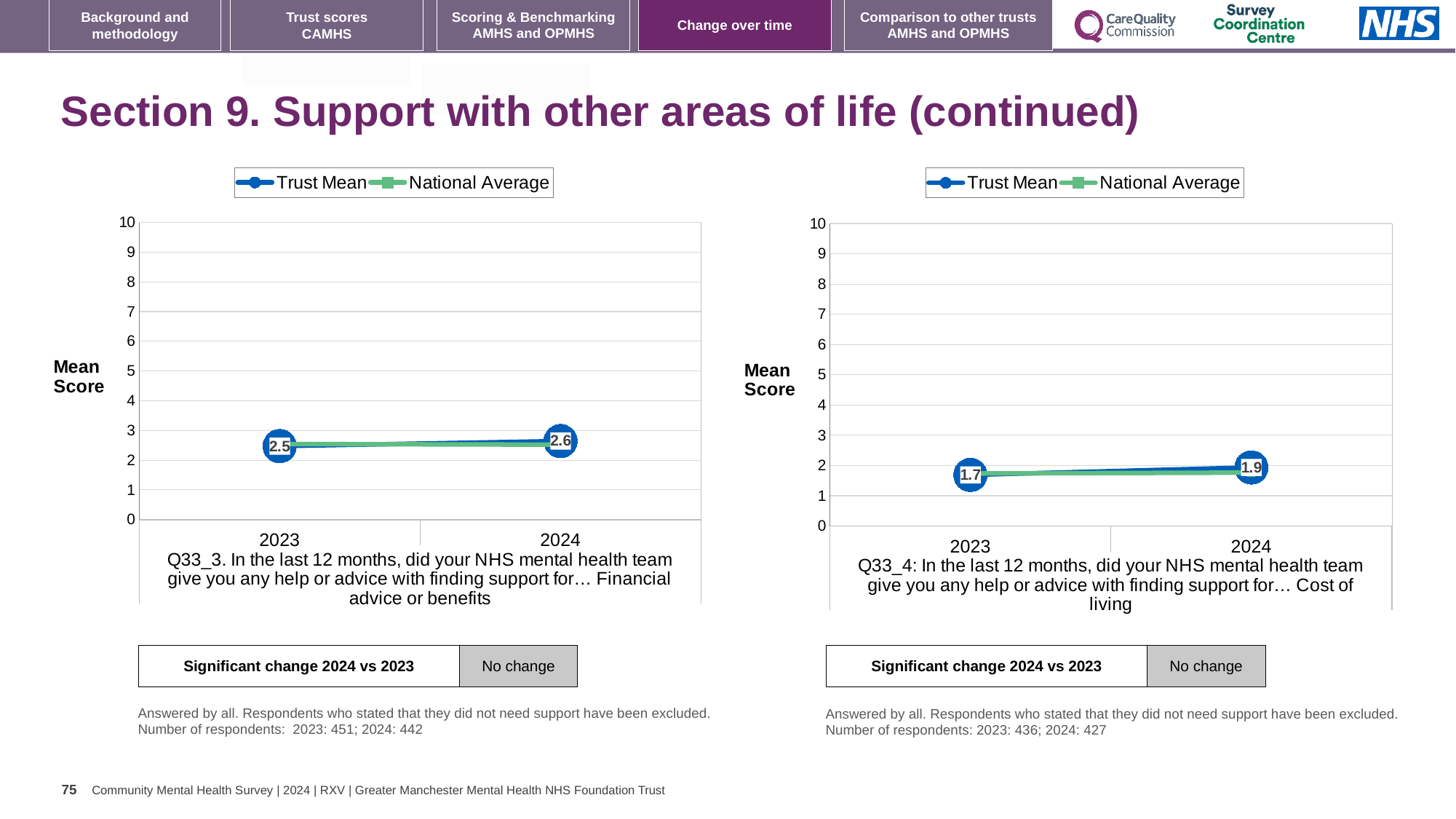
In the left chart (Q33_3, Financial advice or benefits), what is the Trust Mean for 2024? 2.6 How many series does the legend of the left chart list? 2 In the right chart (Q33_4, Cost of living), is the National Average for 2024 greater or less than 5? less In the right chart (Q33_4, Cost of living), by how much did the Trust Mean change from 2023 to 2024? 0.2 In the right chart (Q33_4, Cost of living), what is the Trust Mean for 2024? 1.9 In the left chart (Q33_3, Financial advice or benefits), what is the Trust Mean for 2023? 2.5 In the left chart (Q33_3, Financial advice or benefits), by how much did the Trust Mean change from 2023 to 2024? 0.1 In the left chart (Q33_3, Financial advice or benefits), does the Trust Mean rise or fall from 2023 to 2024? rise In the right chart (Q33_4, Cost of living), which year has the higher Trust Mean, 2023 or 2024? 2024 In the right chart (Q33_4, Cost of living), what is the Trust Mean for 2023? 1.7 What kind of chart is the left chart (Q33_3)? line chart How many years are plotted on the x axis of the right chart? 2